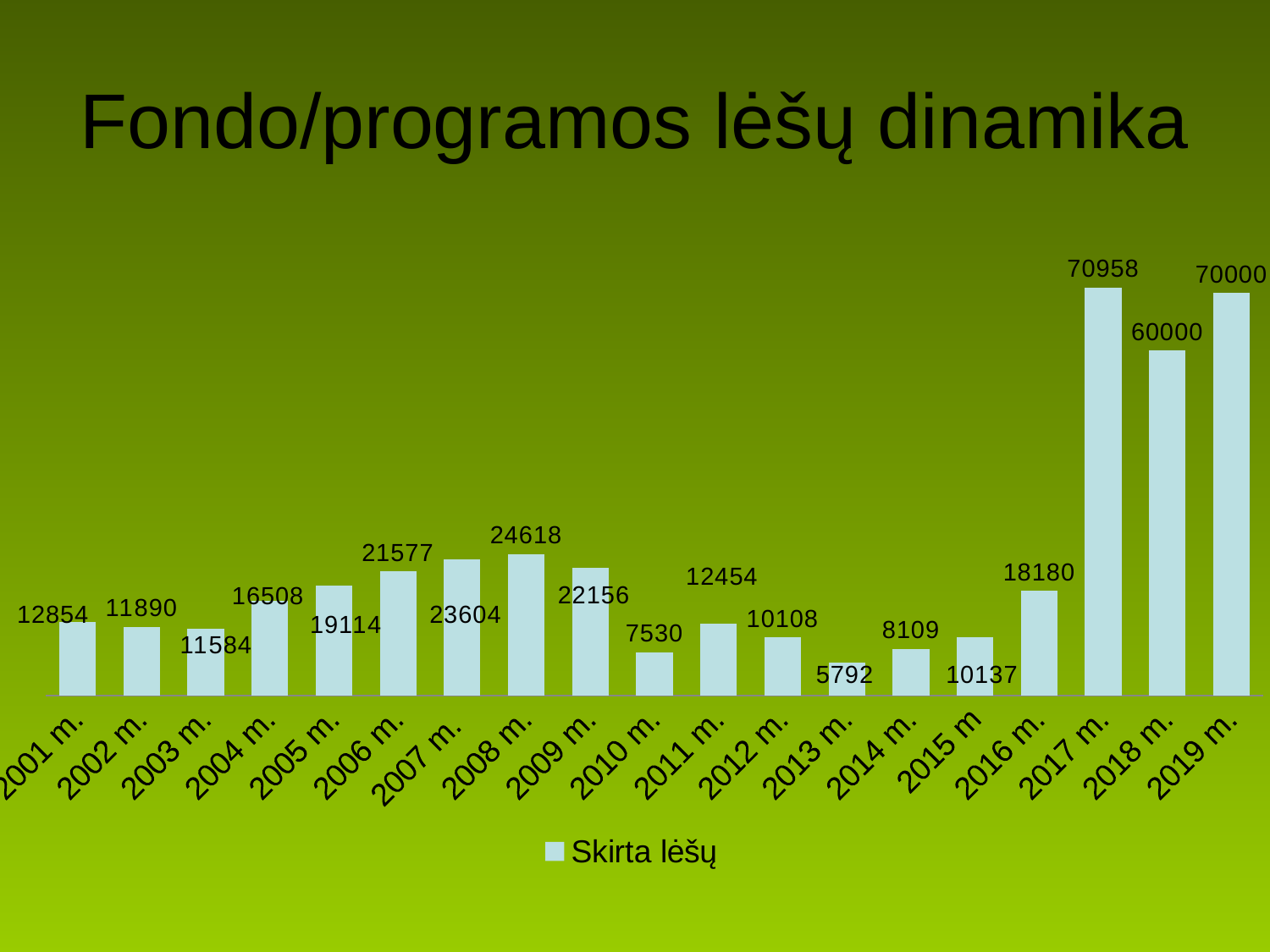
Which year has the lowest value? 2013 m. What is the value for 2008 m.? 24618 How many years are shown on the x axis? 19 How many series does the legend list? 1 What is the difference between the values for 2017 m. and 2018 m.? 10958 What is the difference between the values for 2019 m. and 2016 m.? 51820 What is the value for 2013 m.? 5792 Which is larger, the value for 2010 m. or the value for 2011 m.? 2011 m. What is the title of the chart? Fondo/programos lėšų dinamika What is the value for 2017 m.? 70958 What type of chart is shown on the slide? Bar chart Which year has the highest value? 2017 m.